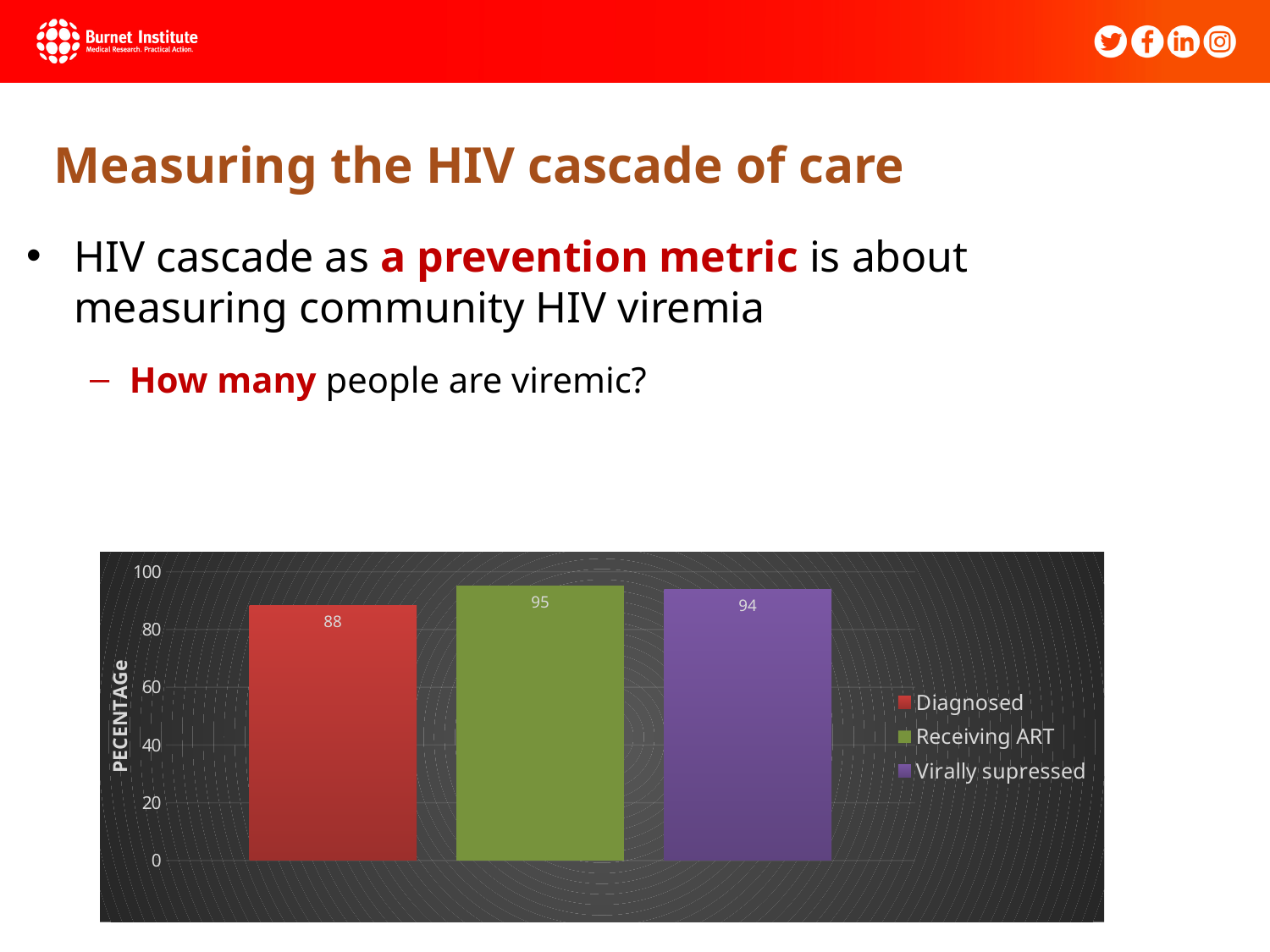
What kind of chart is shown on the slide? bar chart Which is larger, the value for Diagnosed or the value for Virally supressed? Virally supressed How many series does the legend list? 3 What is the value for Virally supressed? 94 What is the label on the vertical axis of the chart? PECENTAGe Which series has the lowest value? Diagnosed Which series has the highest value? Receiving ART What is the difference between the Virally supressed value and the Diagnosed value? 6 What is the value for Receiving ART? 95 Is the value for Diagnosed greater or less than 80? greater What is the difference between the Receiving ART value and the Diagnosed value? 7 What is the value for Diagnosed? 88